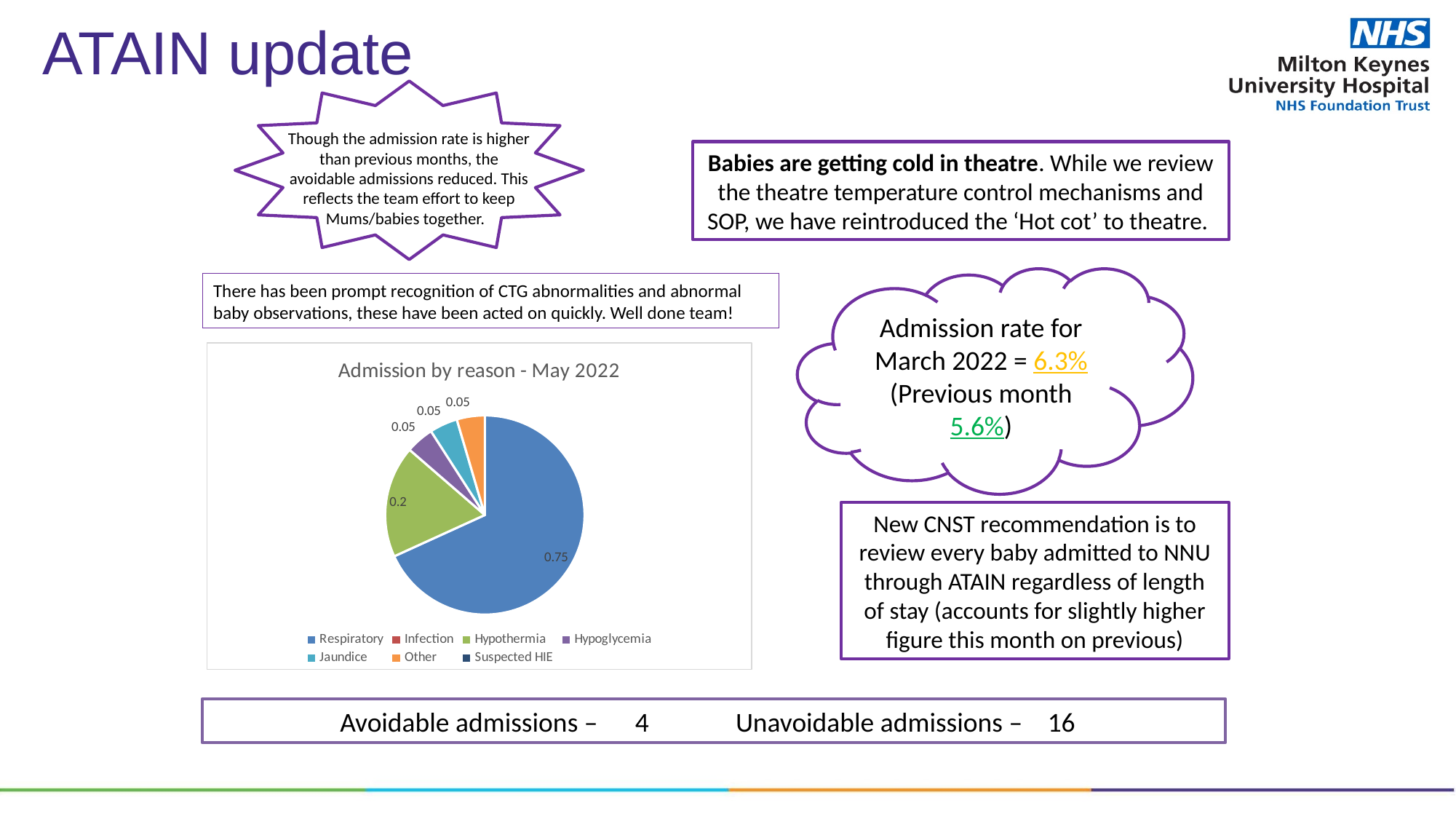
What is the difference between the Hypothermia value and the Other value? 0.15 What value is shown for Hypoglycemia in the pie chart? 0.05 What value is shown for Respiratory in the pie chart? 0.75 How many entries does the chart legend list? 7 What is the difference between the Respiratory value and the Hypothermia value? 0.55 What kind of chart is shown on the slide? pie chart What value is shown for Jaundice in the pie chart? 0.05 What is the title of the chart? Admission by reason - May 2022 Which is larger, the slice for Respiratory or the slice for Hypothermia? Respiratory What value is shown for Hypothermia in the pie chart? 0.2 Which admission reason has the largest slice of the pie? Respiratory What colour is the Respiratory slice in the pie chart? blue